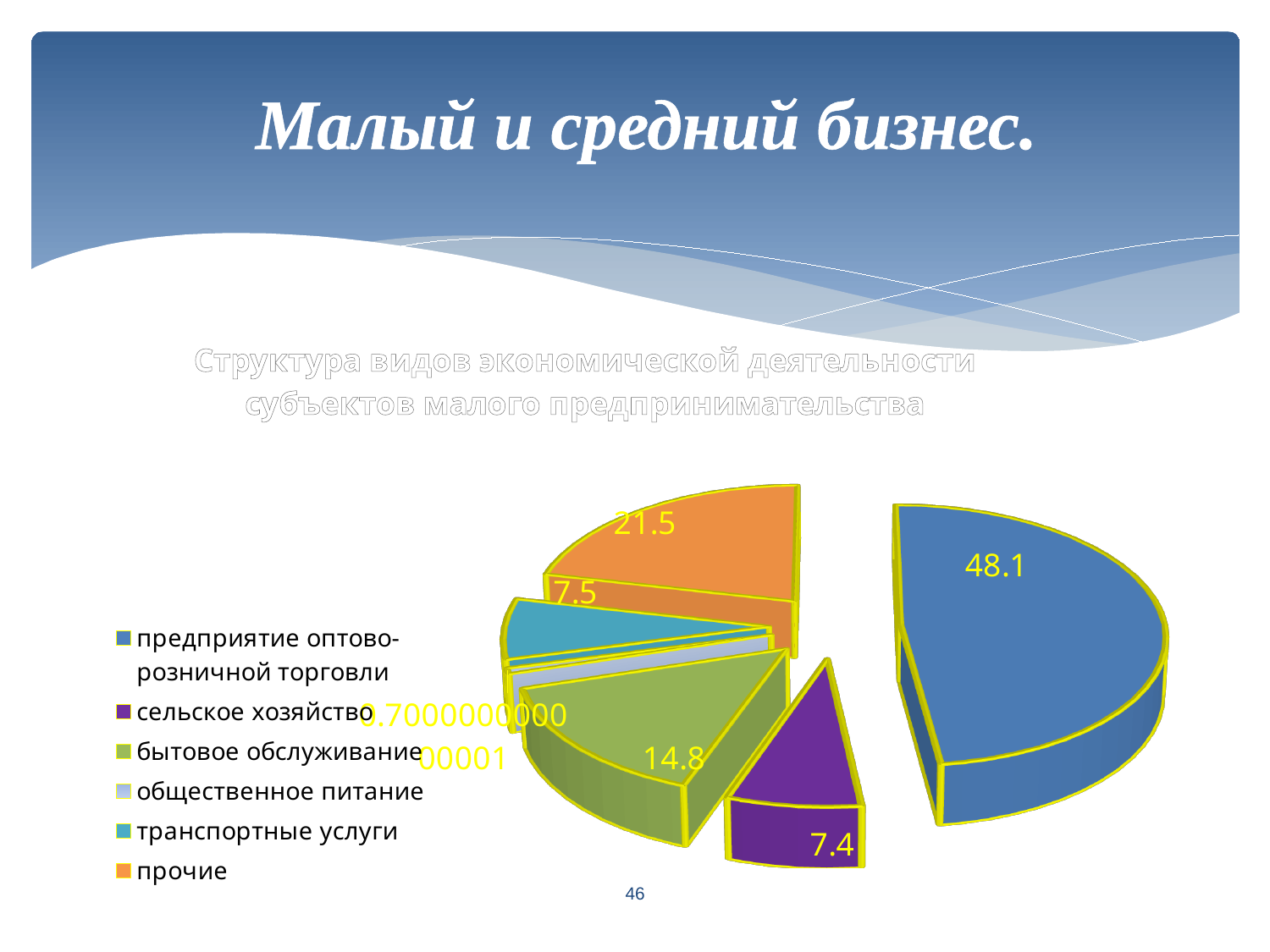
What is the value for сельское хозяйство? 7.4 Which is larger, the value for бытовое обслуживание or the value for прочие? прочие Which category has the largest slice of the pie? предприятие оптово-розничной торговли How many categories does the pie chart show? 6 What is the difference between the values for предприятие оптово-розничной торговли and прочие? 26.6 What is the title of the chart? Структура видов экономической деятельности субъектов малого предпринимательства What is the value for бытовое обслуживание? 14.8 Which category has the smallest slice of the pie? общественное питание What is the value for транспортные услуги? 7.5 What is the value for прочие? 21.5 What is the value for предприятие оптово-розничной торговли? 48.1 What kind of chart is shown on the slide? pie chart